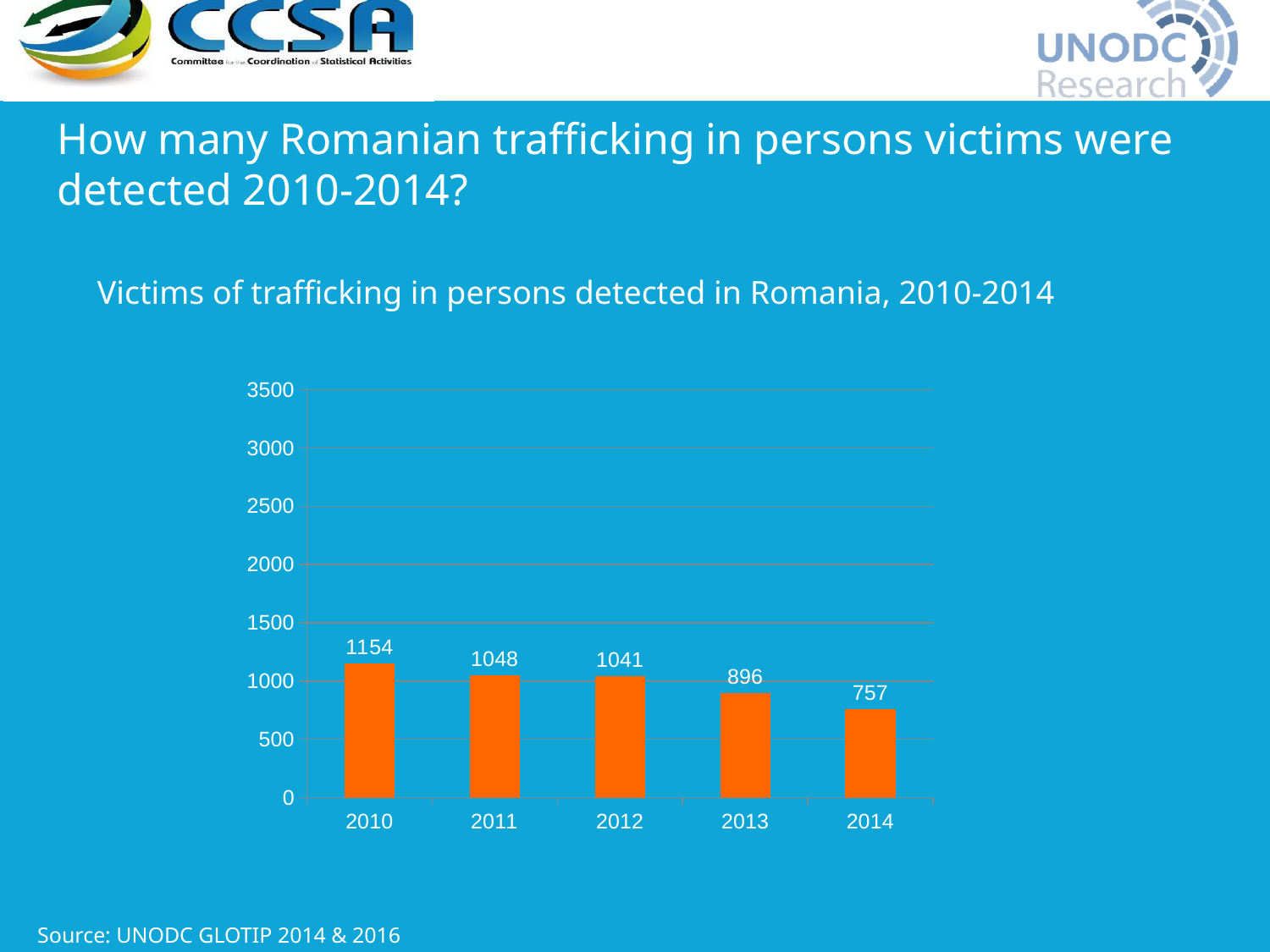
What is the difference between the values for 2010 and 2014? 397 What is the value shown for 2013? 896 Which year has the highest number of detected victims? 2010 Do the values rise or fall from 2010 to 2014? fall Is the value for 2014 greater or less than 1000? less Which is larger, the value for 2011 or the value for 2013? 2011 How many years are shown on the x axis? 5 What is the number of victims of trafficking in persons detected in Romania in 2010? 1154 What is the difference between the values for 2012 and 2013? 145 What kind of chart is shown on the slide? bar chart Which year has the lowest number of detected victims? 2014 What is the value shown for 2014? 757